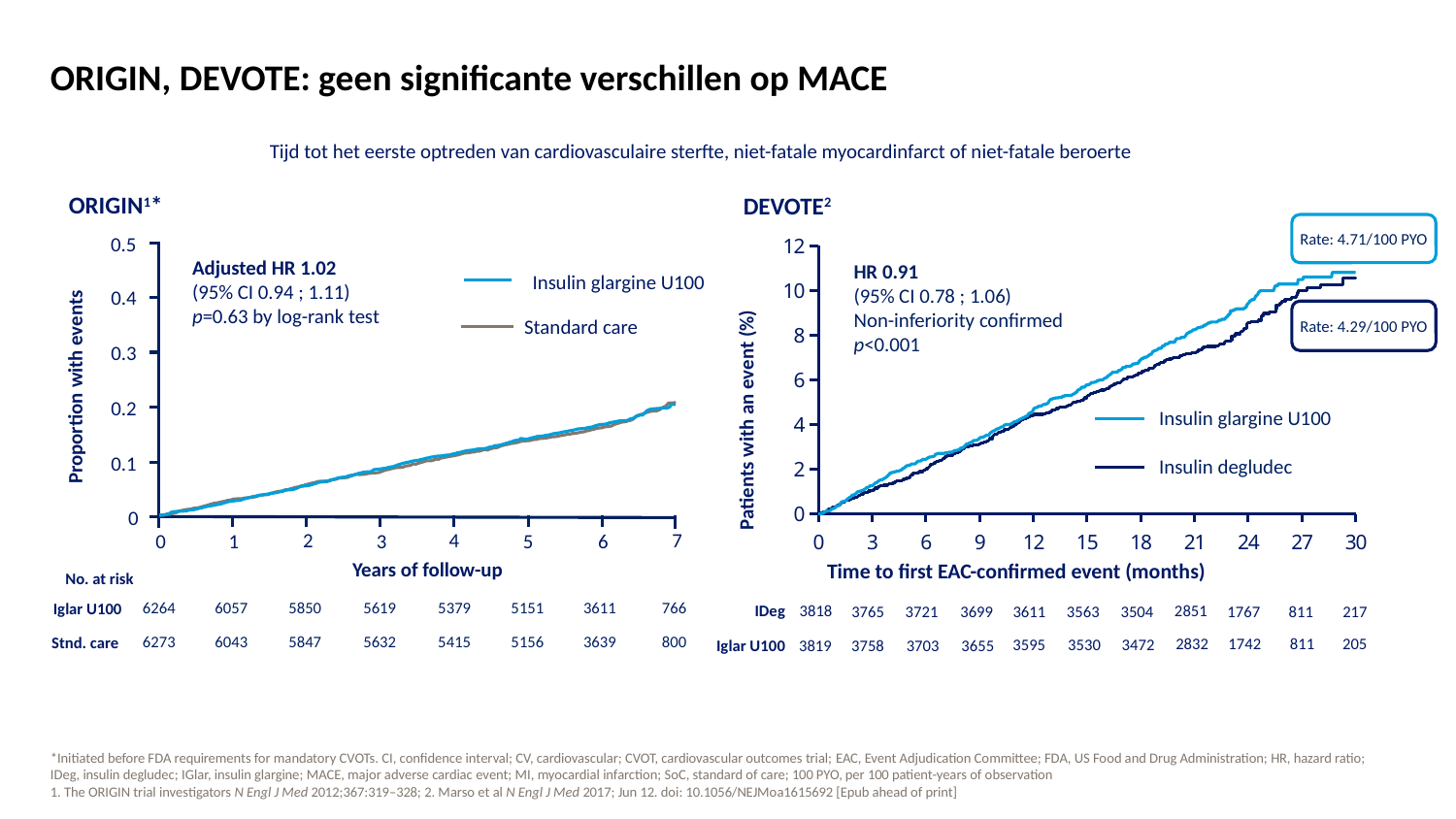
In the DEVOTE chart, do the curves rise or fall as time increases along the x axis? Rise How many series does the legend of the DEVOTE chart list? 2 What kind of chart is the ORIGIN chart on the left? Line chart What hazard ratio is shown on the DEVOTE chart? 0.91 In the DEVOTE chart, is the percentage of patients with an event for Insulin glargine U100 at 30 months greater or less than 8? greater What is the x-axis label of the DEVOTE chart? Time to first EAC-confirmed event (months) In the DEVOTE chart, what is the difference between the two event rates shown (4.71/100 PYO and 4.29/100 PYO)? 0.42/100 PYO In the ORIGIN chart, is the proportion with events for Insulin glargine U100 at year 7 greater or less than 0.3? less How many series does the legend of the ORIGIN chart list? 2 What adjusted hazard ratio is shown on the ORIGIN chart? 1.02 Which two series are listed in the legend of the DEVOTE chart? Insulin glargine U100 and Insulin degludec In the DEVOTE chart, which series has the higher event rate per 100 PYO, Insulin glargine U100 or Insulin degludec? Insulin glargine U100